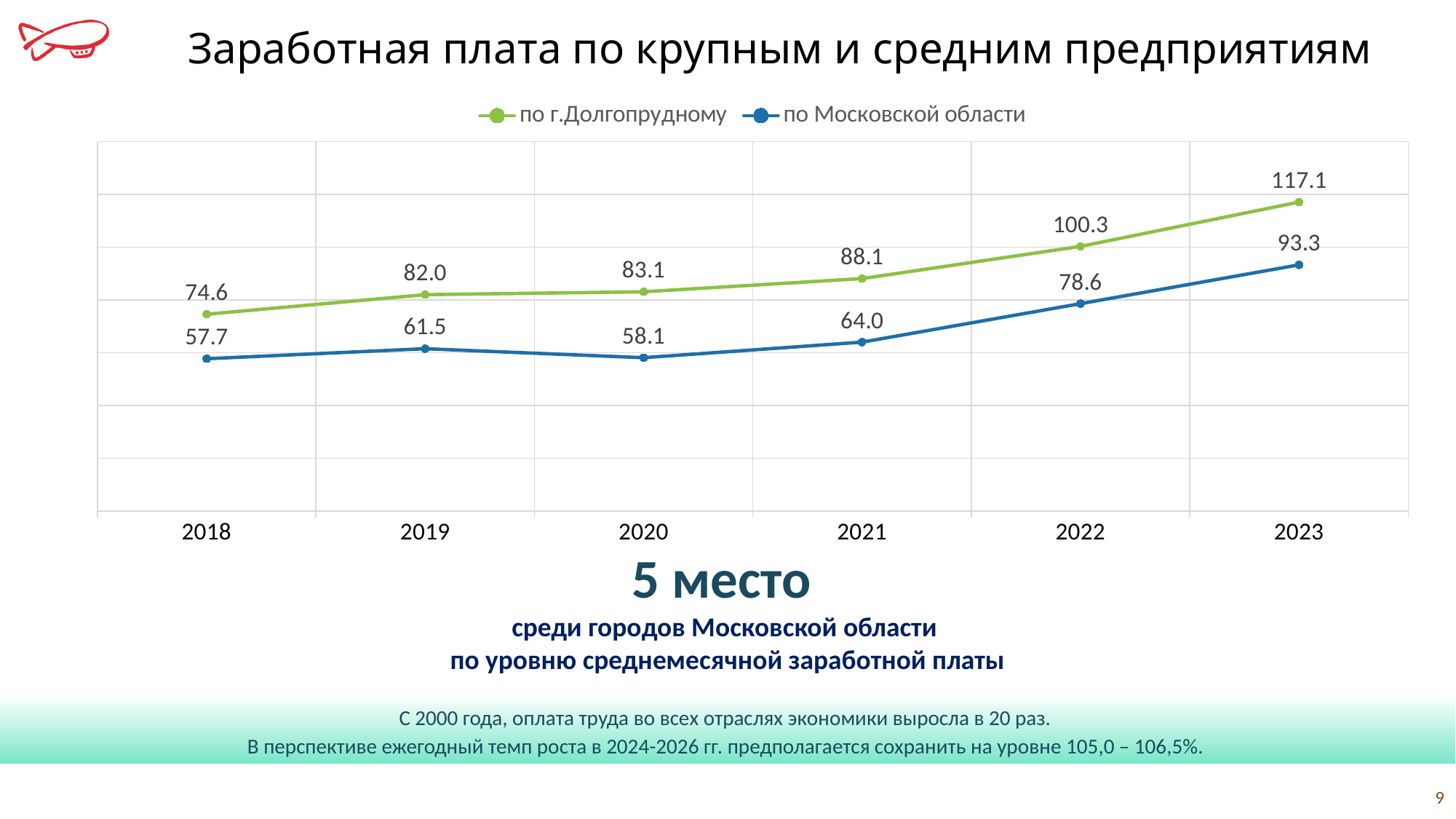
What is the difference between по г.Долгопрудному and по Московской области in 2022? 21.7 What colour is the line for по Московской области? blue How many series does the legend list? 2 In which year is the value for по Московской области the lowest? 2018 What is the value for по Московской области in 2020? 58.1 How many years are shown on the x axis? 6 What is the value for по г.Долгопрудному in 2018? 74.6 What kind of chart is shown on the slide? line chart Which series has the larger value in 2021, по г.Долгопрудному or по Московской области? по г.Долгопрудному In which year is the value for по г.Долгопрудному the highest? 2023 What is the value for по г.Долгопрудному in 2023? 117.1 Do the values for по г.Долгопрудному rise or fall from 2018 to 2023? rise